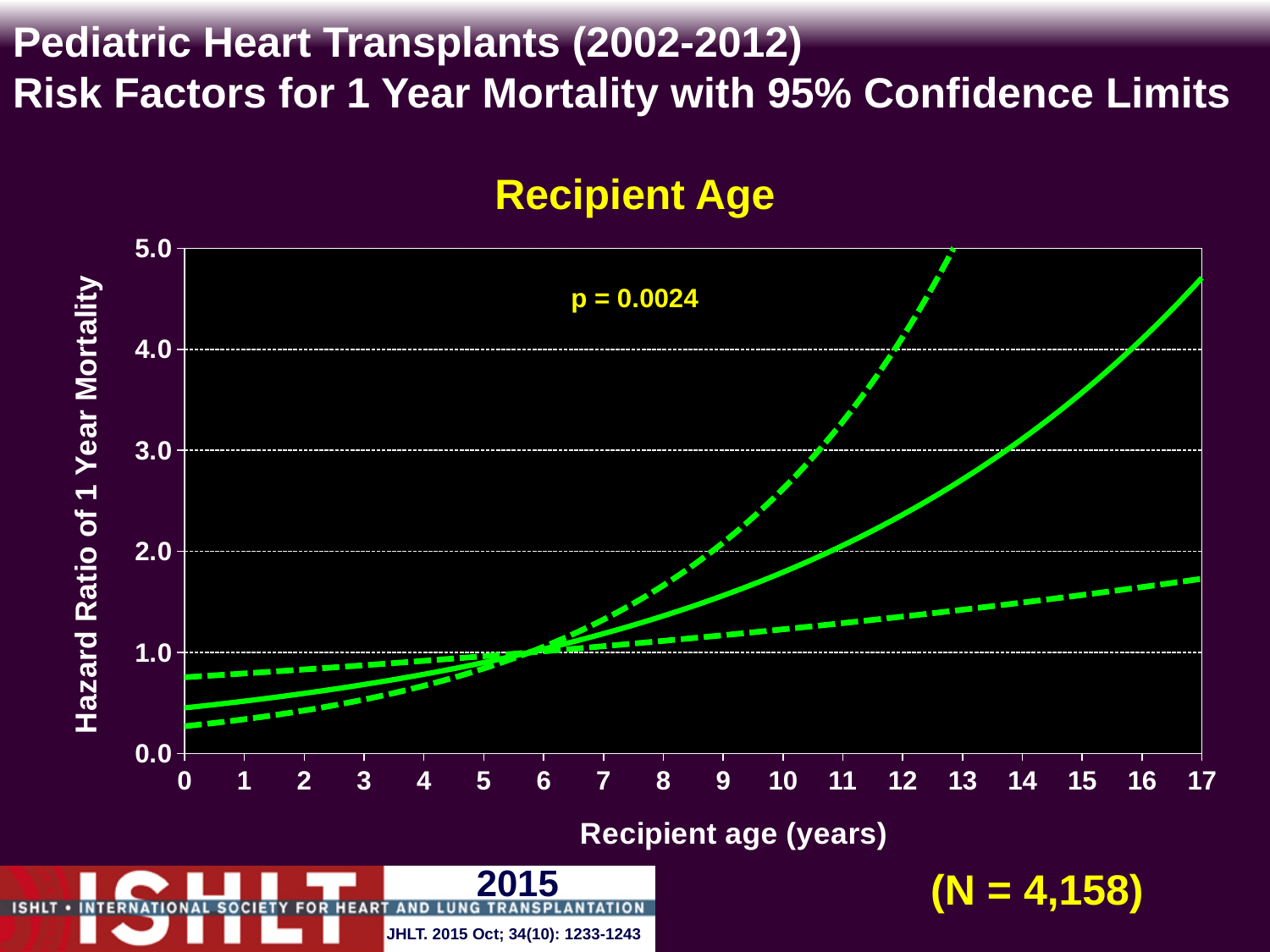
Is the hazard ratio (solid line) at recipient age 15 greater or less than 3.0? greater Is the lower confidence limit (lower dashed line) at recipient age 17 greater or less than 2.0? less Is the hazard ratio (solid line) at recipient age 10 greater or less than 2.0? less What is the highest value shown on the y axis? 5.0 What kind of chart is shown on the slide? line chart What p-value is printed on the chart? p = 0.0024 Does the hazard ratio of 1 year mortality rise or fall as recipient age increases? rise What is the label of the x axis? Recipient age (years) How many lines are plotted on the chart? 3